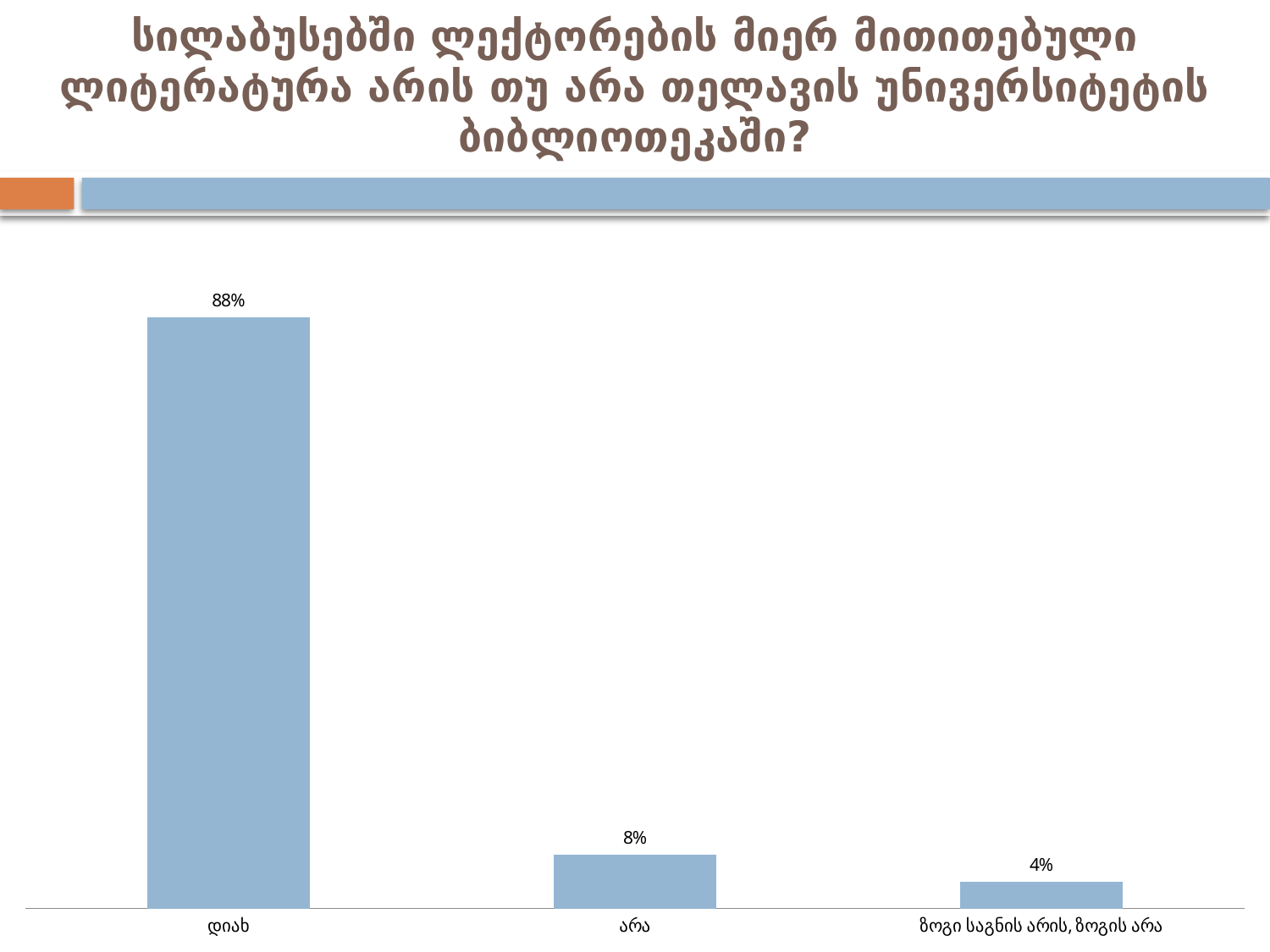
How many categories are shown on the chart? 3 Do the values rise or fall from left to right across the categories? Fall What kind of chart is shown on the slide? Bar chart Which category has the highest value? დიახ Which category has the lowest value? ზოგი საგნის არის, ზოგის არა What value is shown for the category "ზოგი საგნის არის, ზოგის არა"? 4% What colour are the bars in the chart? Light blue What value is shown for the category "დიახ"? 88% What value is shown for the category "არა"? 8% What is the difference between the values for "არა" and "ზოგი საგნის არის, ზოგის არა"? 4% What is the difference between the values for "დიახ" and "არა"? 80% Which is larger, the value for "არა" or the value for "ზოგი საგნის არის, ზოგის არა"? არა